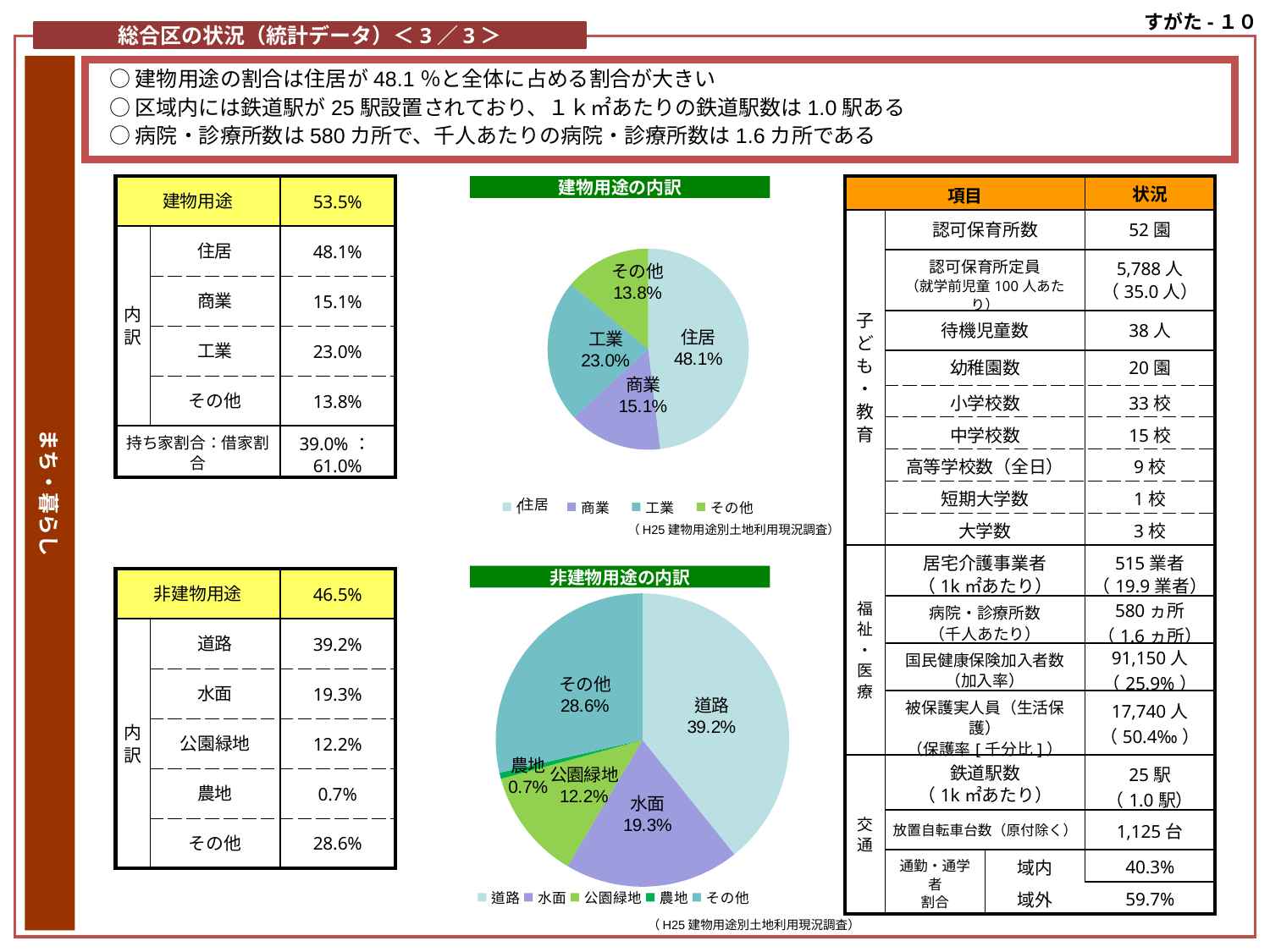
In the 非建物用途の内訳 pie chart, what is the difference between the shares of 道路 and その他? 10.6% In the 非建物用途の内訳 pie chart, what is the share for 農地? 0.7% How many categories does the 建物用途の内訳 pie chart show? 4 In the 建物用途の内訳 pie chart, what is the share for 工業? 23.0% In the 建物用途の内訳 pie chart, which category has the smallest share? その他 In the 建物用途の内訳 pie chart, what is the difference between the shares of 工業 and 商業? 7.9% In the 非建物用途の内訳 pie chart, what is the share for 道路? 39.2% In the 建物用途の内訳 pie chart, which category has the largest share? 住居 In the 非建物用途の内訳 pie chart, which is larger, 水面 or 公園緑地? 水面 How many categories does the legend of the 非建物用途の内訳 pie chart list? 5 In the 建物用途の内訳 pie chart, what is the share for 住居? 48.1% What type of chart is the 非建物用途の内訳 chart? Pie chart